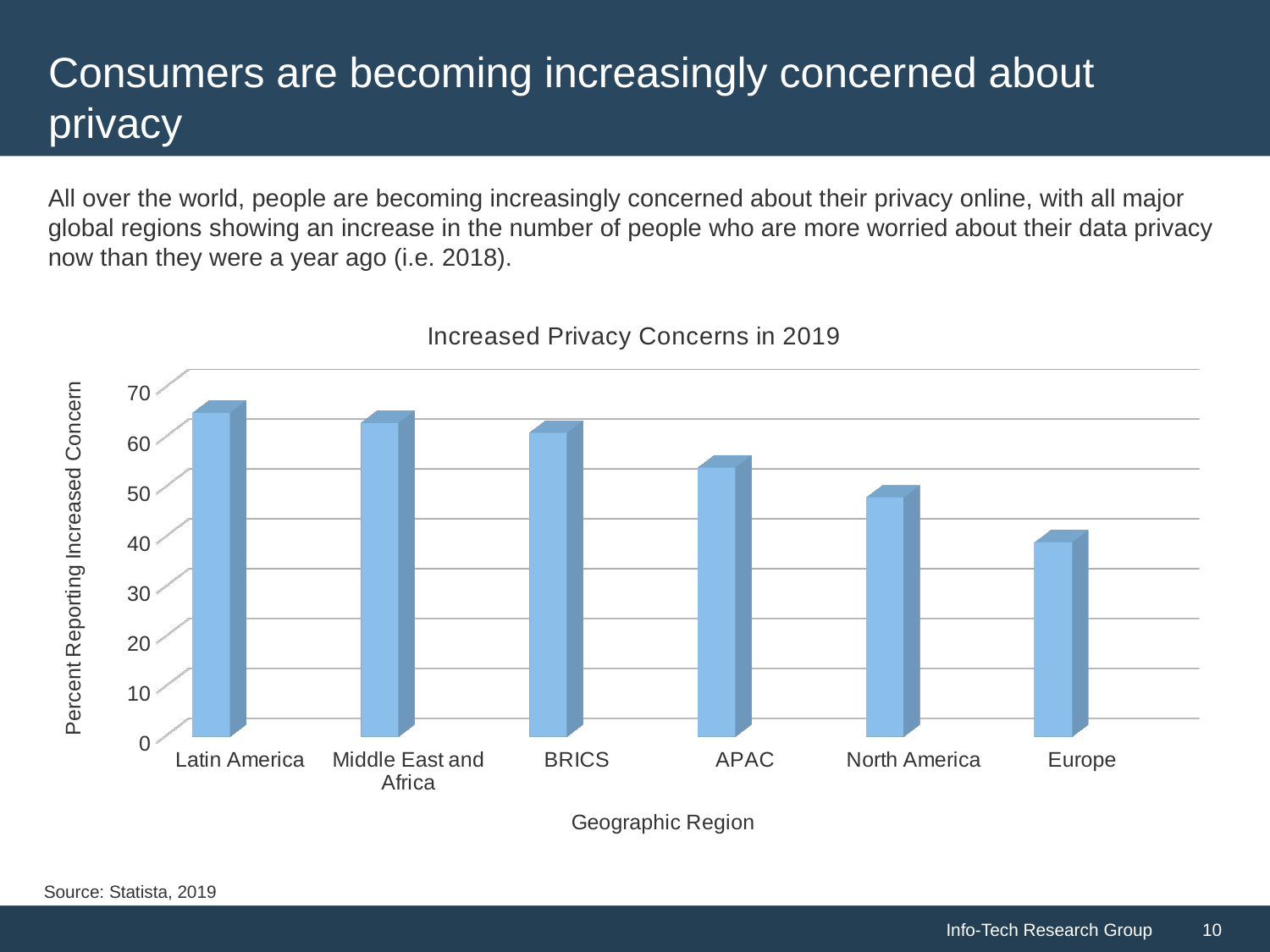
Which region has the highest percent reporting increased concern? Latin America Is the value for Latin America greater or less than 60? greater Which has a higher value, APAC or North America? APAC Is the value for BRICS greater or less than 50? greater Which region has the lowest percent reporting increased concern? Europe Is the value for North America greater or less than 40? greater What is the title of the chart? Increased Privacy Concerns in 2019 What kind of chart is shown on the slide? Bar chart Which has a higher value, Europe or Latin America? Latin America Do the values rise or fall moving from left to right across the regions? fall How many geographic regions are shown in the chart? 6